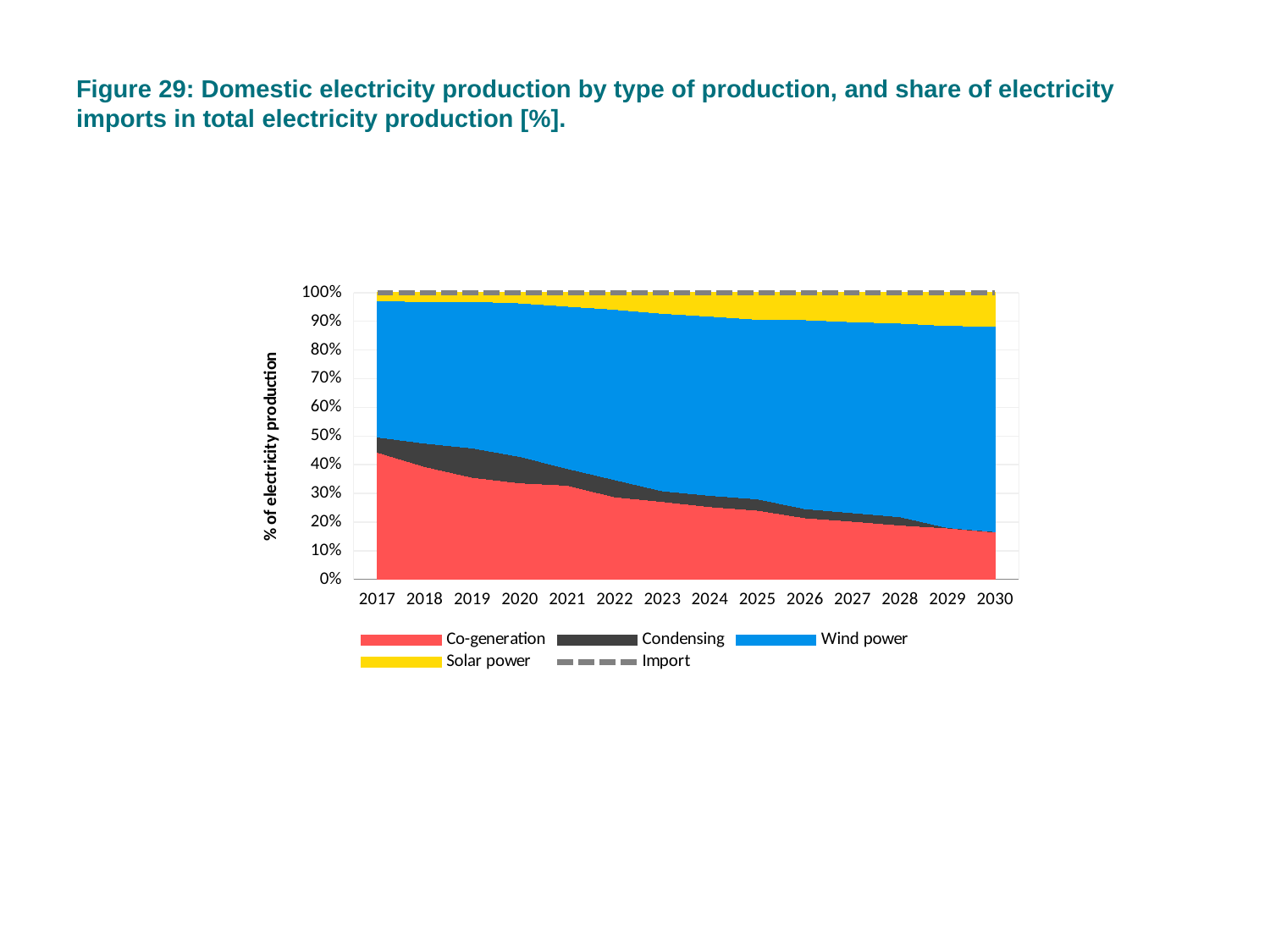
What is the label of the y axis? % of electricity production Which year is the first shown on the x axis? 2017 Does the share of Wind power rise or fall from 2017 to 2030? Rise Does the share of Co-generation rise or fall from 2017 to 2030? Fall Which series is shown in blue? Wind power How many series does the chart's legend list? 5 What kind of chart is shown on the slide? Stacked area chart Is the share of Co-generation in 2017 greater or less than 40%? greater How many years are shown along the x axis of the chart? 14 Is the share of Co-generation in 2030 greater or less than 20%? less